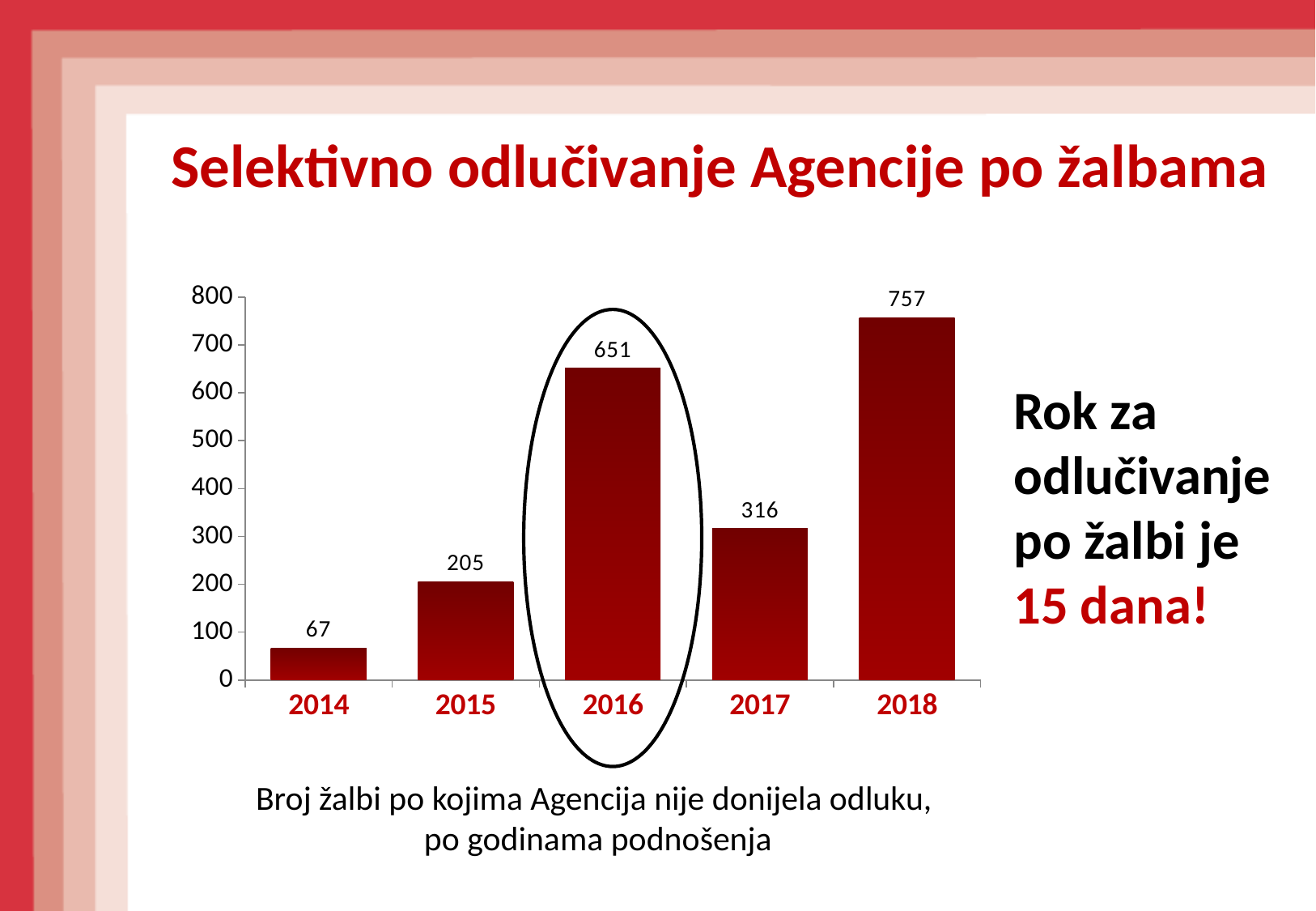
What is the value for 2016? 651 Which is larger, the value for 2016 or the value for 2017? 2016 Which year has the highest value? 2018 Which year has the lowest value? 2014 What is the value for 2014? 67 Is the value for 2017 greater or less than 300? greater Which year's bar is circled on the chart? 2016 What is the difference between the values for 2016 and 2015? 446 How many years are shown on the x axis? 5 What is the value for 2018? 757 What is the difference between the values for 2018 and 2017? 441 What kind of chart is shown on the slide? bar chart